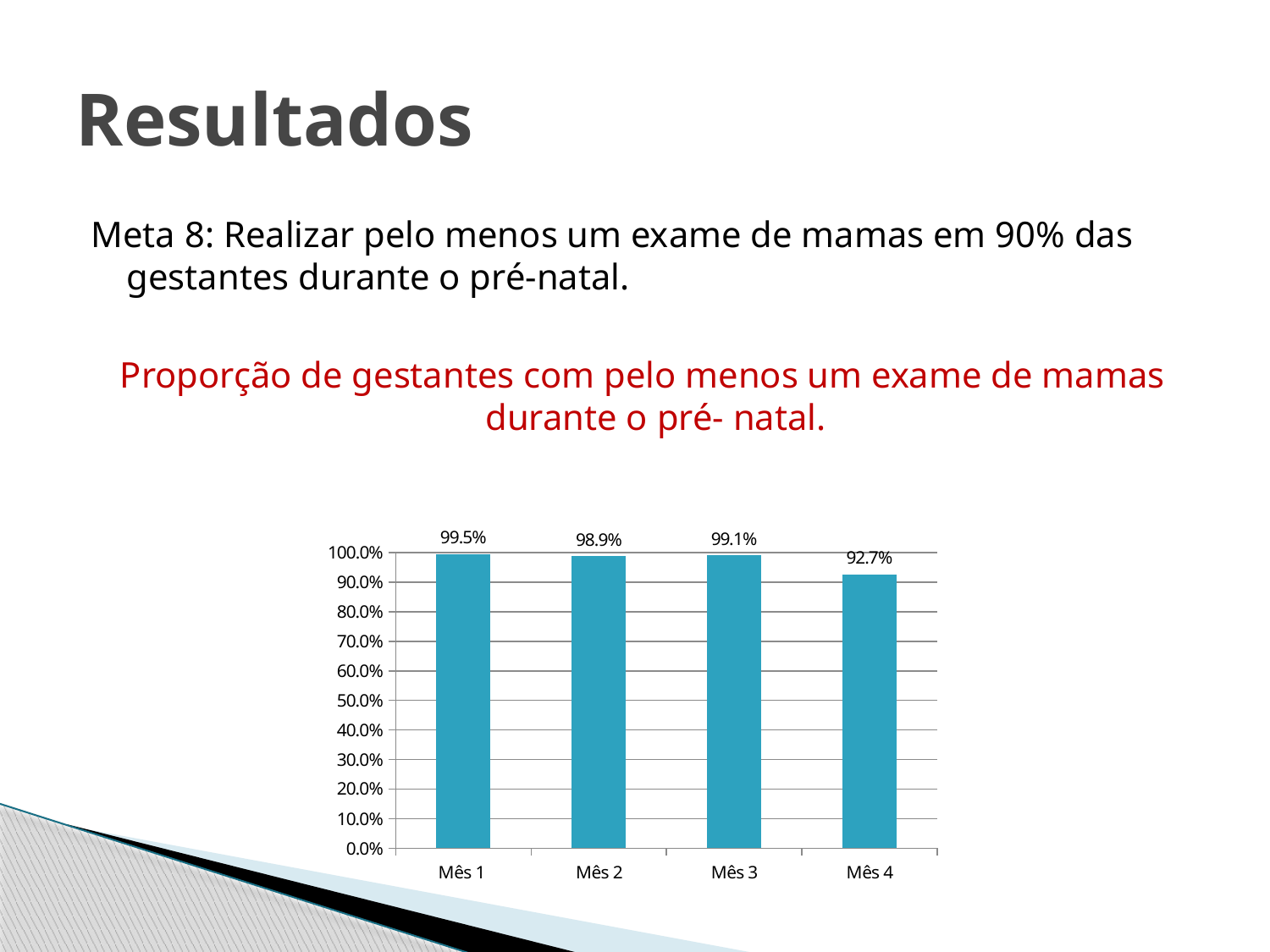
Which month has the lowest value? Mês 4 Which is larger, the value for Mês 3 or the value for Mês 4? Mês 3 What is the value for Mês 4? 92.7% How many months are shown on the x axis? 4 Is the value for Mês 4 greater or less than 90.0%? greater Which month has the highest value? Mês 1 What is the value for Mês 2? 98.9% What is the value for Mês 1? 99.5% What is the difference between the values for Mês 3 and Mês 2? 0.2% What is the title of the chart shown in red above it? Proporção de gestantes com pelo menos um exame de mamas durante o pré- natal. What kind of chart is shown on the slide? bar chart What is the difference between the values for Mês 1 and Mês 4? 6.8%